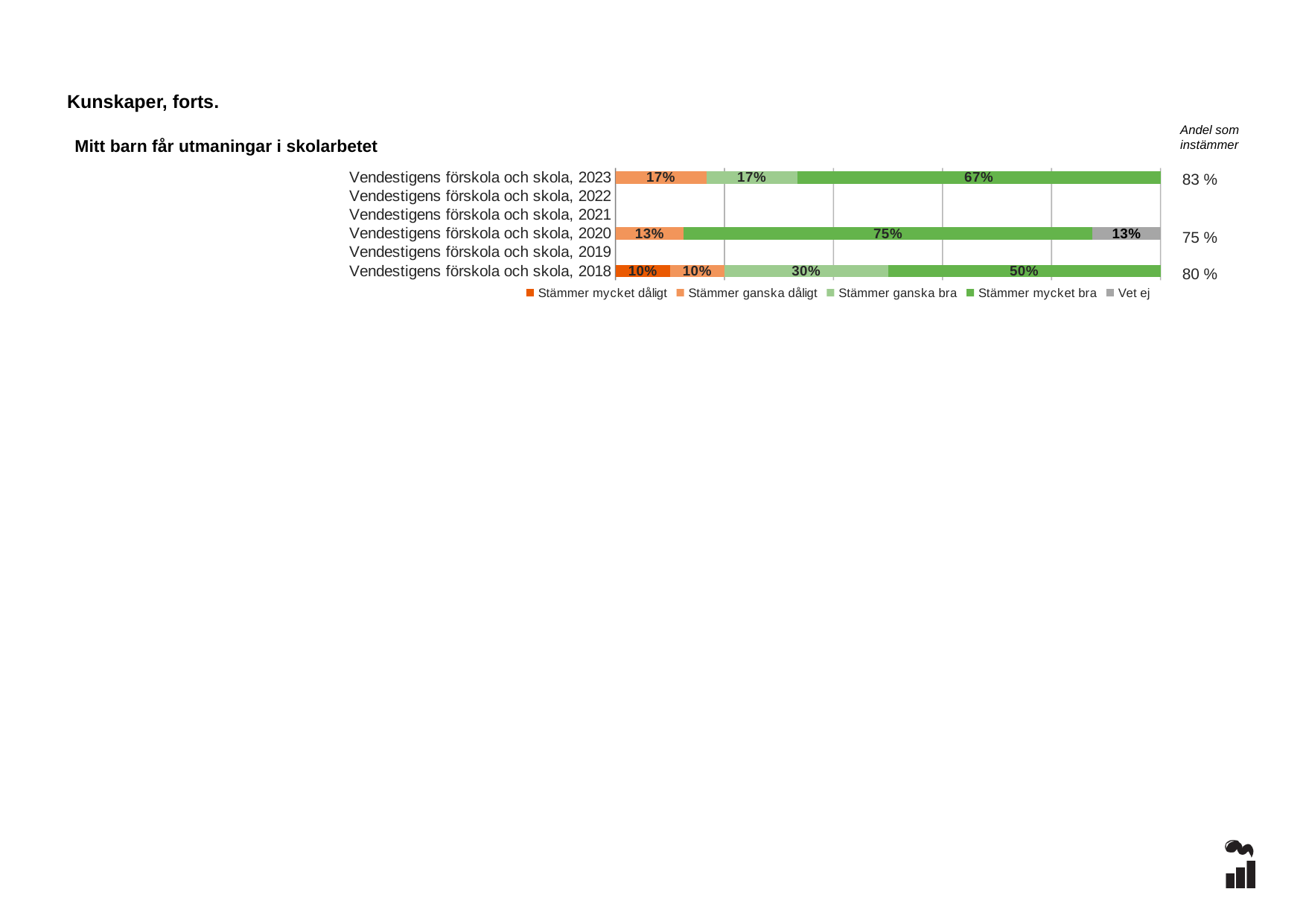
What kind of chart is shown on the slide? Stacked bar chart What is the value for "Stämmer ganska dåligt" for Vendestigens förskola och skola, 2020? 13% What is the difference between the "Stämmer mycket bra" values for 2020 and 2018? 25% What is the "Andel som instämmer" value shown for Vendestigens förskola och skola, 2023? 83 % What is the value for "Stämmer mycket bra" for Vendestigens förskola och skola, 2023? 67% What is the value for "Stämmer ganska bra" for Vendestigens förskola och skola, 2018? 30% Which year has the lowest "Andel som instämmer" value? 2020 Which is larger: the "Stämmer ganska bra" value for 2018 or for 2023? 2018 How many series does the legend list? 5 Which year has the highest "Stämmer mycket bra" value? 2020 What is the title of the chart? Mitt barn får utmaningar i skolarbetet What is the value for "Vet ej" for Vendestigens förskola och skola, 2020? 13%